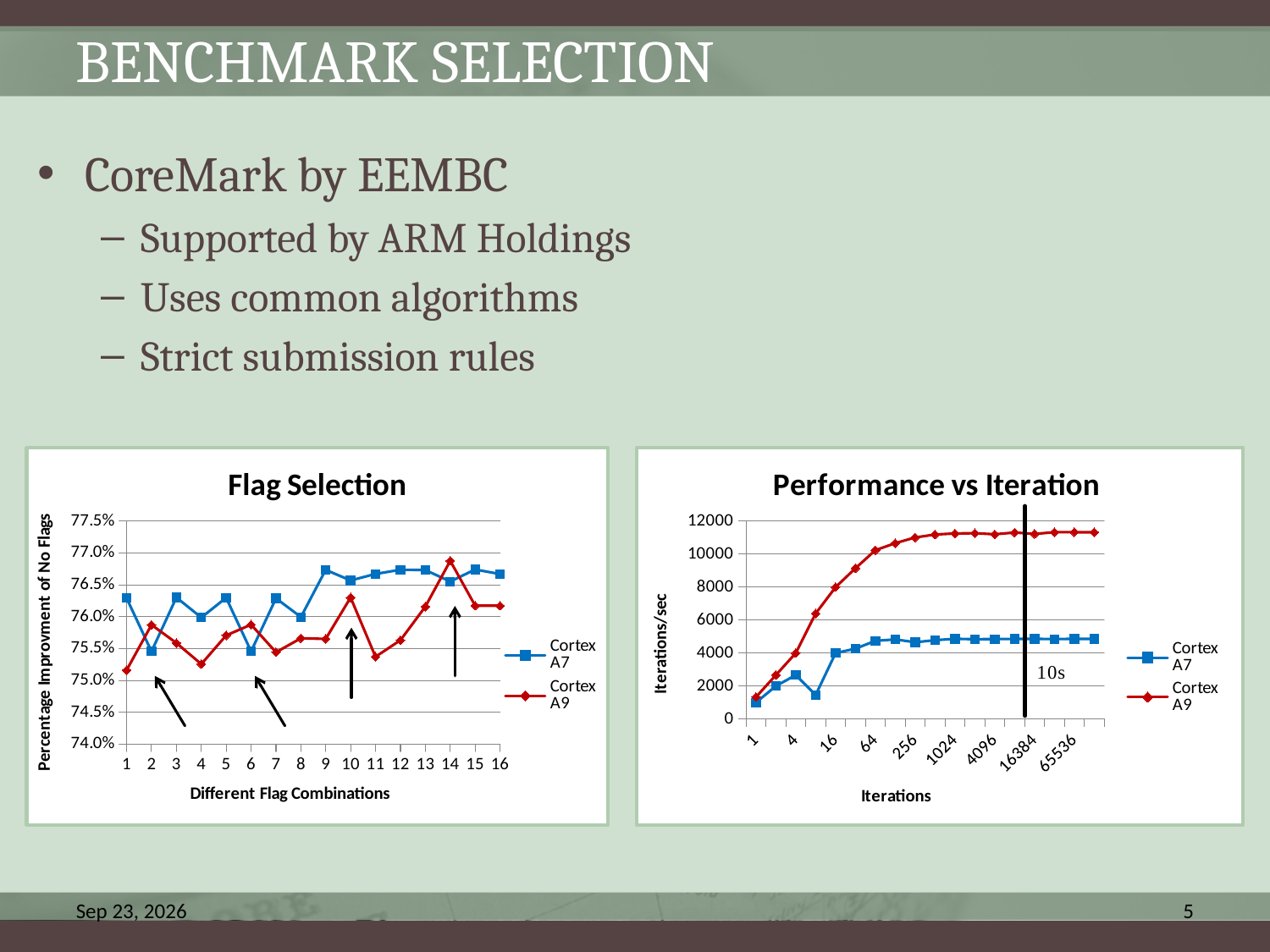
What kind of chart is the Performance vs Iteration chart? line chart How many series does the legend of the Flag Selection chart list? 2 How many flag combinations are shown on the x axis of the Flag Selection chart? 16 In the Flag Selection chart, which series has the higher value at flag combination 9, Cortex A7 or Cortex A9? Cortex A7 In the Flag Selection chart, at which flag combination does Cortex A9 have its lowest value? 1 What is the y-axis title of the Performance vs Iteration chart? Iterations/sec What kind of chart is the Flag Selection chart? line chart In the Flag Selection chart, is the Cortex A7 value at flag combination 9 greater or less than 76.5%? greater In the Performance vs Iteration chart, is the Cortex A9 value at 65536 iterations greater or less than 10000? greater In the Flag Selection chart, which series has the higher value at flag combination 14, Cortex A7 or Cortex A9? Cortex A9 In the Flag Selection chart, at which flag combination does Cortex A9 reach its highest value? 14 In the Performance vs Iteration chart, is the Cortex A7 value at 65536 iterations greater or less than 6000? less